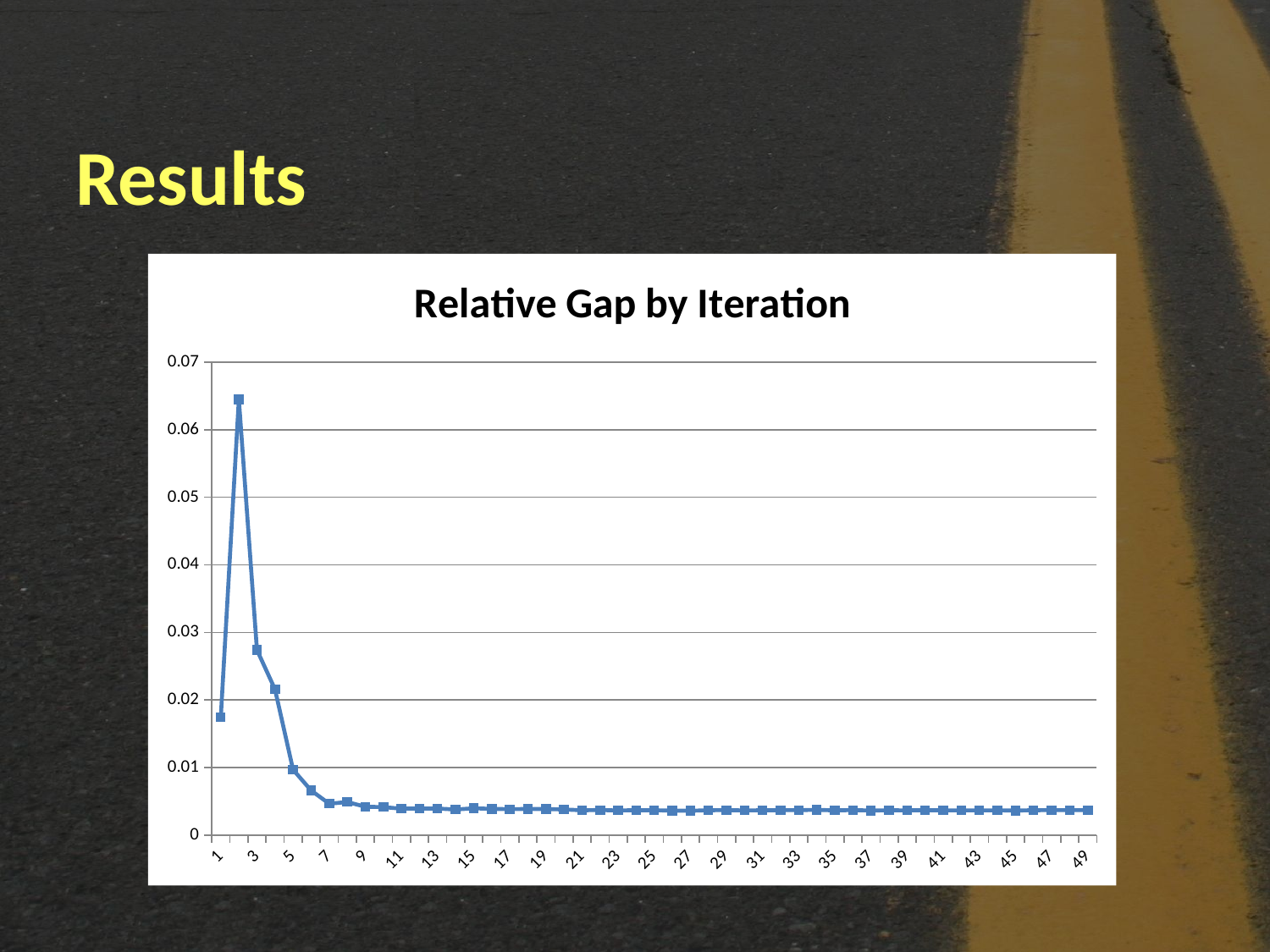
After the peak near the start, do the values rise or fall as the iteration number increases? fall Which has the larger value, iteration 3 or iteration 5? iteration 3 What kind of chart is shown on the slide? line chart Is the value at iteration 49 greater or less than 0.01? less What is the title of the chart? Relative Gap by Iteration Is the highest value on the chart greater or less than 0.06? greater What is the highest value shown on the y axis? 0.07 Which has the larger value, iteration 1 or iteration 3? iteration 3 Is the value at iteration 3 greater or less than 0.02? greater